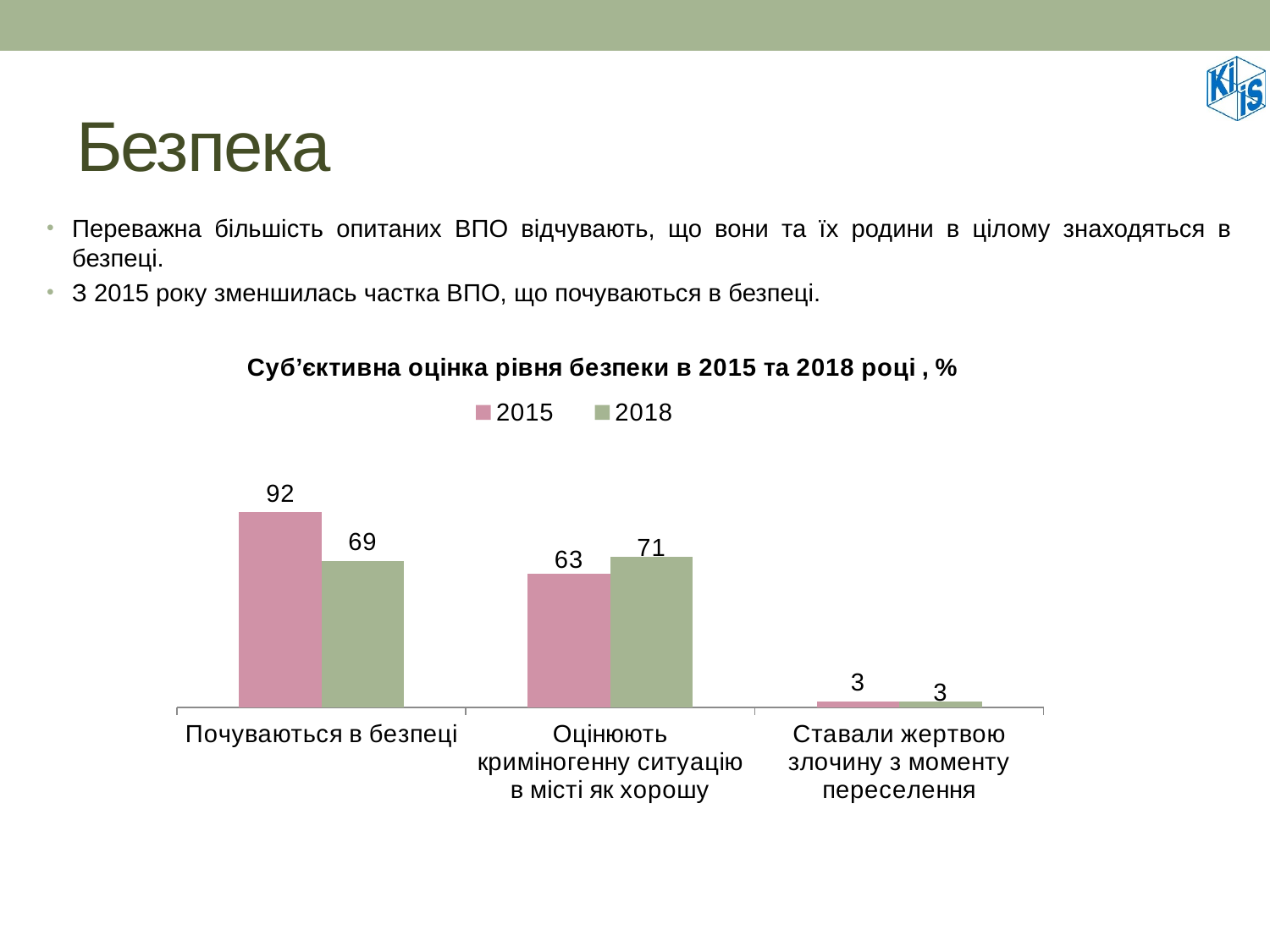
How many series does the legend list? 2 Which category has the highest 2015 value? Почуваються в безпеці Which category has the lowest 2018 value? Ставали жертвою злочину з моменту переселення How many categories are shown on the x axis? 3 What is the 2015 value for "Почуваються в безпеці"? 92 For "Оцінюють криміногенну ситуацію в місті як хорошу", which year has the larger value, 2015 or 2018? 2018 What is the difference between the 2015 and 2018 values for "Почуваються в безпеці"? 23 What is the title of the chart? Суб’єктивна оцінка рівня безпеки в 2015 та 2018 році , % Which series is shown in pink? 2015 What is the 2018 value for "Почуваються в безпеці"? 69 What is the 2018 value for "Оцінюють криміногенну ситуацію в місті як хорошу"? 71 What kind of chart is shown on the slide? Bar chart